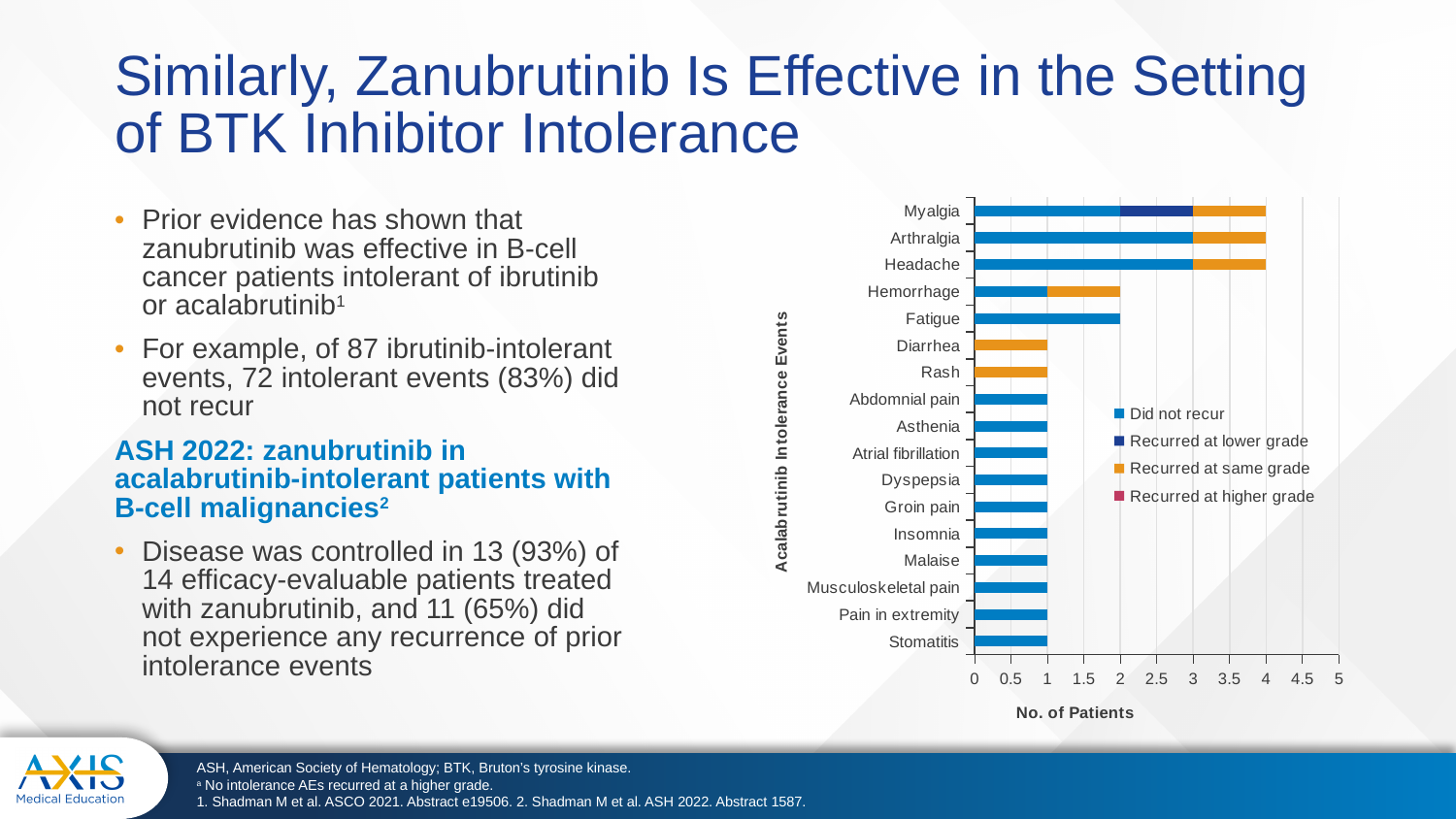
How many acalabrutinib intolerance events are listed on the y axis of the chart? 17 How many series does the chart legend list? 4 How many patients with Headache recurred at same grade? 1 How many patients with Myalgia did not recur? 2 How many patients with Arthralgia did not recur? 3 Which legend entry is shown in dark blue? Recurred at lower grade What is the label of the x axis of the chart? No. of Patients What kind of chart is shown on the slide? Stacked bar chart What is the total number of patients for the Hemorrhage bar? 2 What is the total number of patients for the Myalgia bar? 4 What is the difference between the total number of patients for Arthralgia and for Hemorrhage? 2 Which has more patients in total, Fatigue or Stomatitis? Fatigue